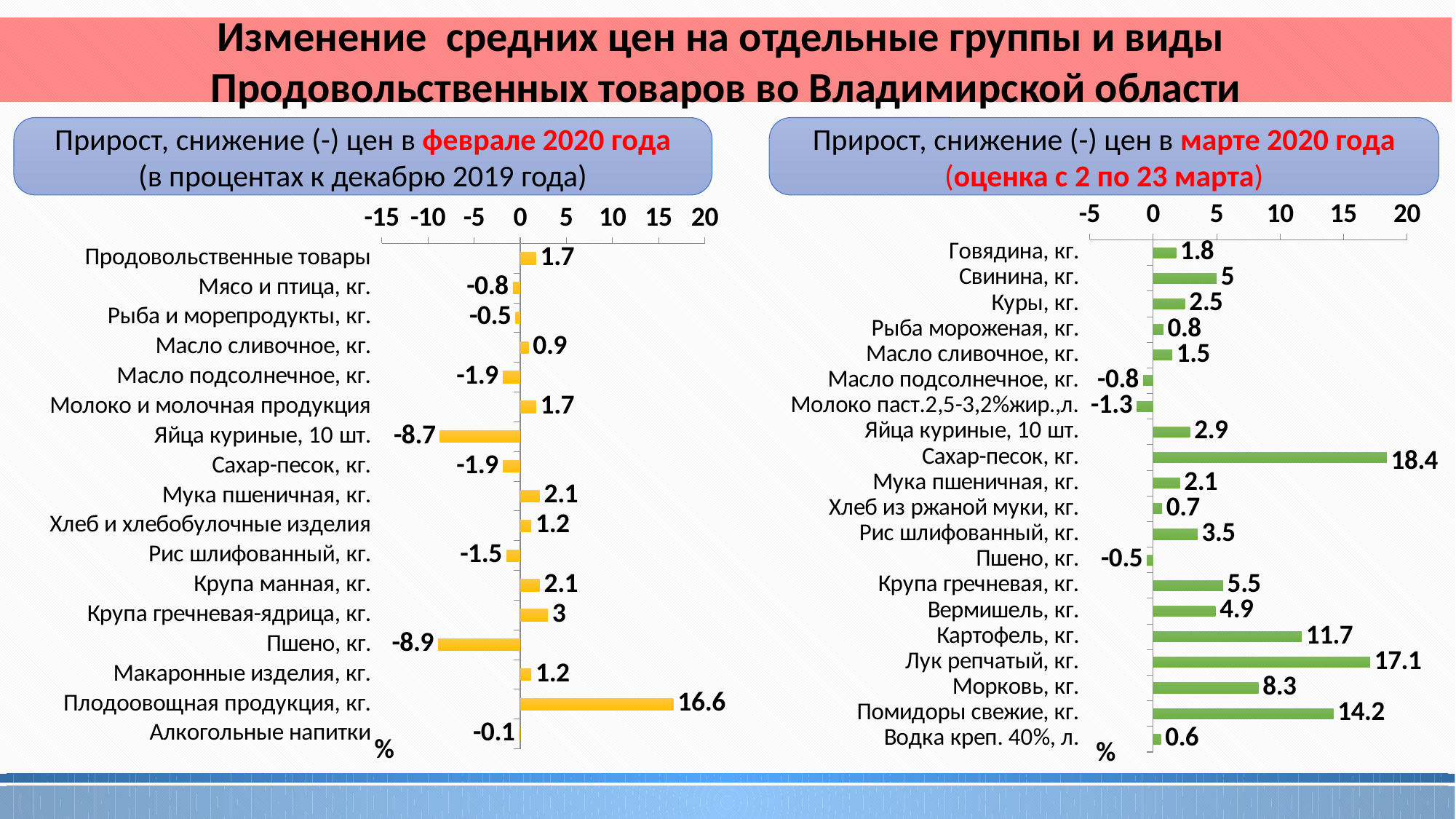
On the left chart (February 2020), what is the value for Яйца куриные, 10 шт.? -8.7 On the right chart (March 2020), how many categories are plotted? 20 On the right chart (March 2020), which category has the lowest value? Молоко паст.2,5-3,2%жир.,л. On the left chart (February 2020), what is the value for Плодоовощная продукция, кг.? 16.6 On the left chart (February 2020), how many categories are plotted? 17 On the right chart (March 2020), which category has the highest value? Сахар-песок, кг. What type of chart is the left chart (February 2020)? Bar chart On the left chart (February 2020), which category has the lowest value? Пшено, кг. On the left chart (February 2020), which category has the highest value? Плодоовощная продукция, кг. On the right chart (March 2020), which is larger: the value for Морковь, кг. or the value for Помидоры свежие, кг.? Помидоры свежие, кг. On the right chart (March 2020), what is the value for Сахар-песок, кг.? 18.4 On the right chart (March 2020), what is the difference between the values for Лук репчатый, кг. and Картофель, кг.? 5.4